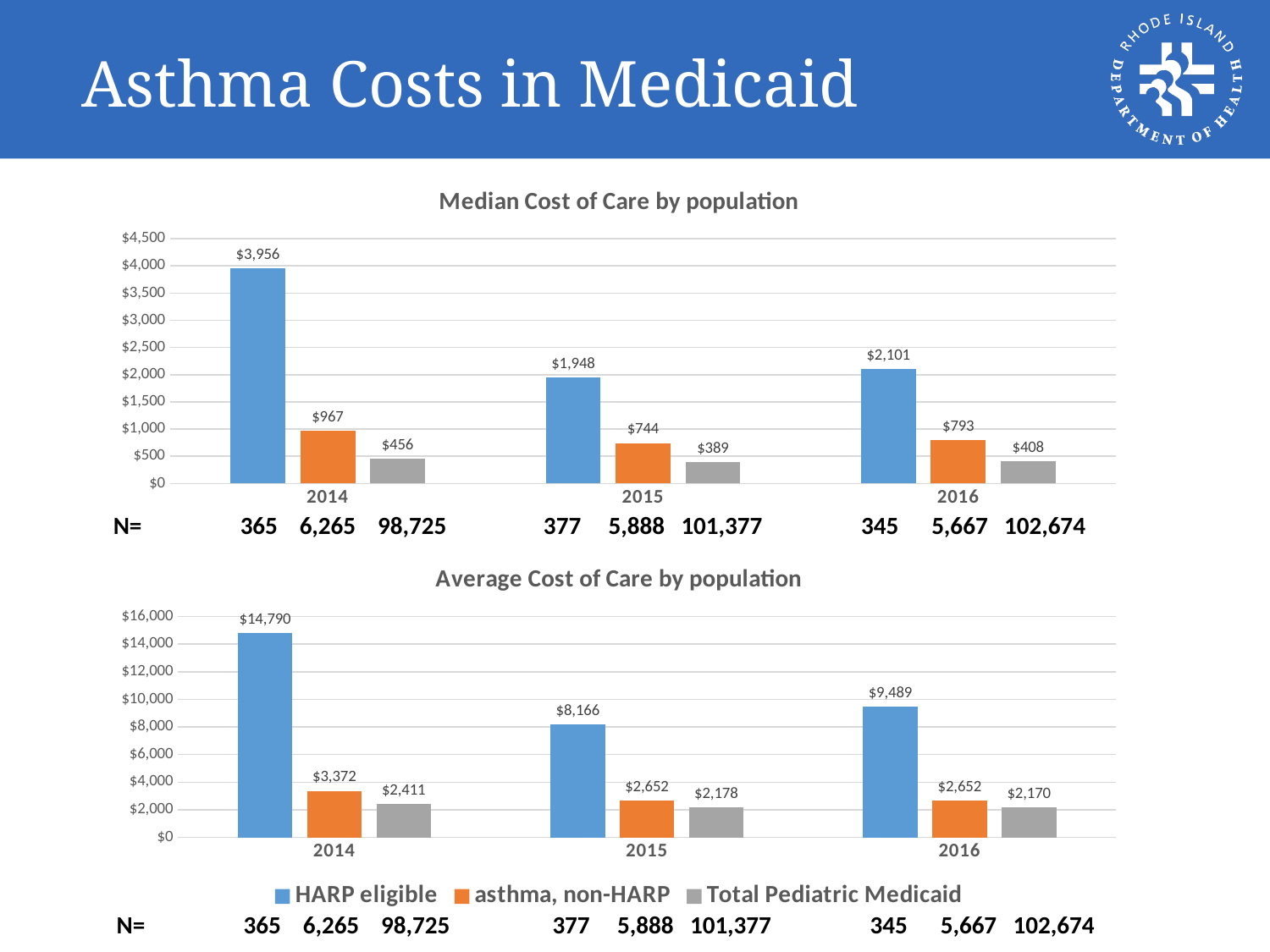
In the 'Average Cost of Care by population' chart, how does the Total Pediatric Medicaid average cost change from 2014 to 2016? It falls In the 'Median Cost of Care by population' chart, what is the difference between the HARP eligible and asthma, non-HARP median costs in 2016? $1,308 In the 'Average Cost of Care by population' chart, which year has the lowest average cost for Total Pediatric Medicaid? 2016 In the 'Average Cost of Care by population' chart, what is the average cost for asthma, non-HARP in 2014? $3,372 In the 'Median Cost of Care by population' chart, is the asthma, non-HARP median cost larger in 2015 or in 2016? 2016 In the 'Average Cost of Care by population' chart, what is the difference between the HARP eligible average cost in 2014 and in 2015? $6,624 In the 'Median Cost of Care by population' chart, what is the median cost for Total Pediatric Medicaid in 2015? $389 How many series does the legend list on the slide? 3 In the 'Median Cost of Care by population' chart, which year has the highest median cost for HARP eligible? 2014 In the 'Median Cost of Care by population' chart, what is the median cost for HARP eligible in 2014? $3,956 What kind of chart is the 'Average Cost of Care by population' chart? Bar chart In the 'Average Cost of Care by population' chart, what is the average cost for HARP eligible in 2016? $9,489